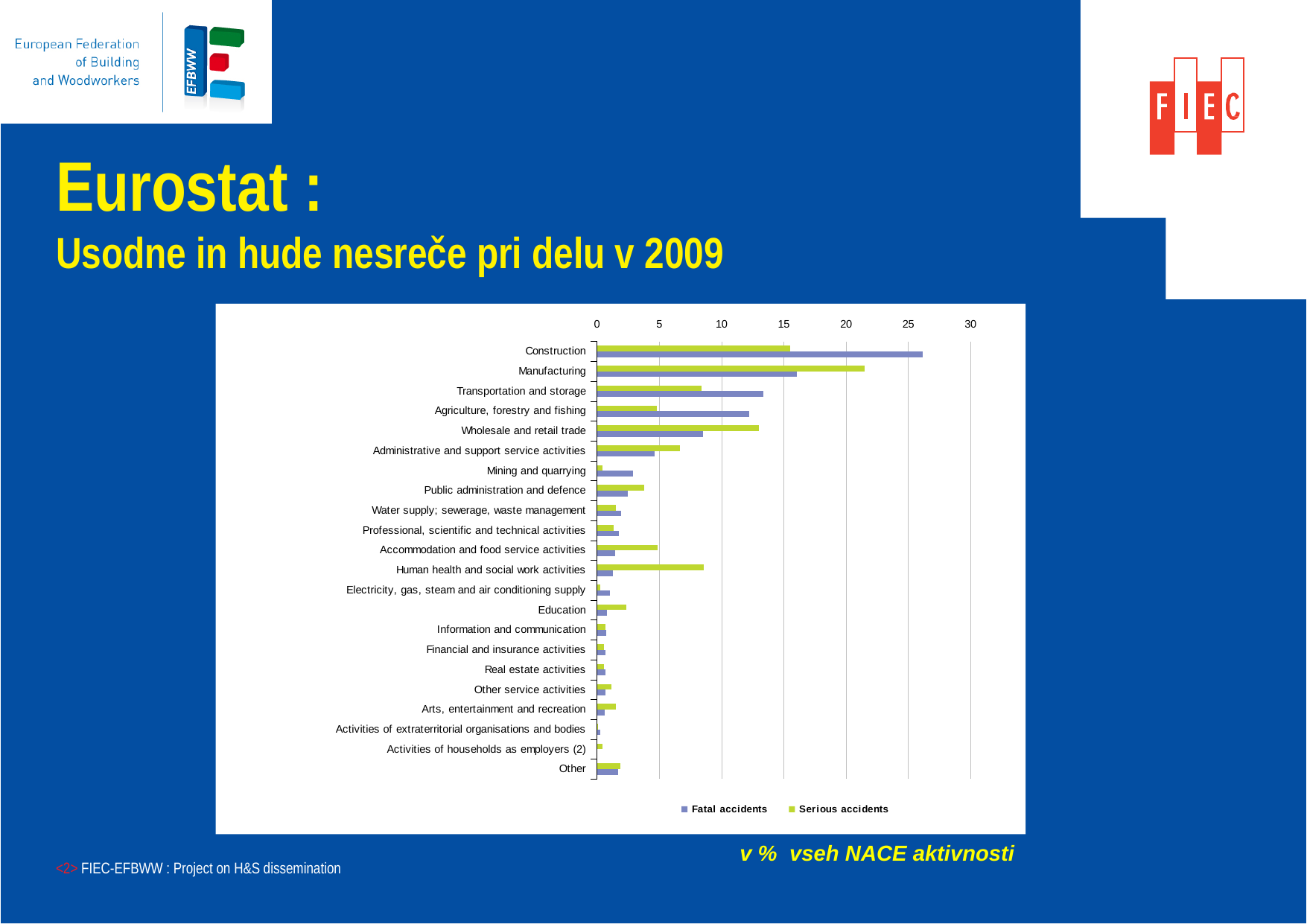
Is the Serious accidents value for Manufacturing greater or less than 20? greater Which sector has the highest value for Serious accidents? Manufacturing Which colour represents the Serious accidents series in the chart? green For Human health and social work activities, which series has the larger value: Fatal accidents or Serious accidents? Serious accidents Is the Fatal accidents value for Construction greater or less than 25? greater Which is larger: the Fatal accidents value for Construction or the Fatal accidents value for Manufacturing? Construction How many categories (sectors) are plotted on the chart? 22 Which sector has the highest value for Fatal accidents? Construction Is the Fatal accidents value for Transportation and storage greater or less than 10? greater What kind of chart is shown on the slide? bar chart How many series does the chart's legend list? 2